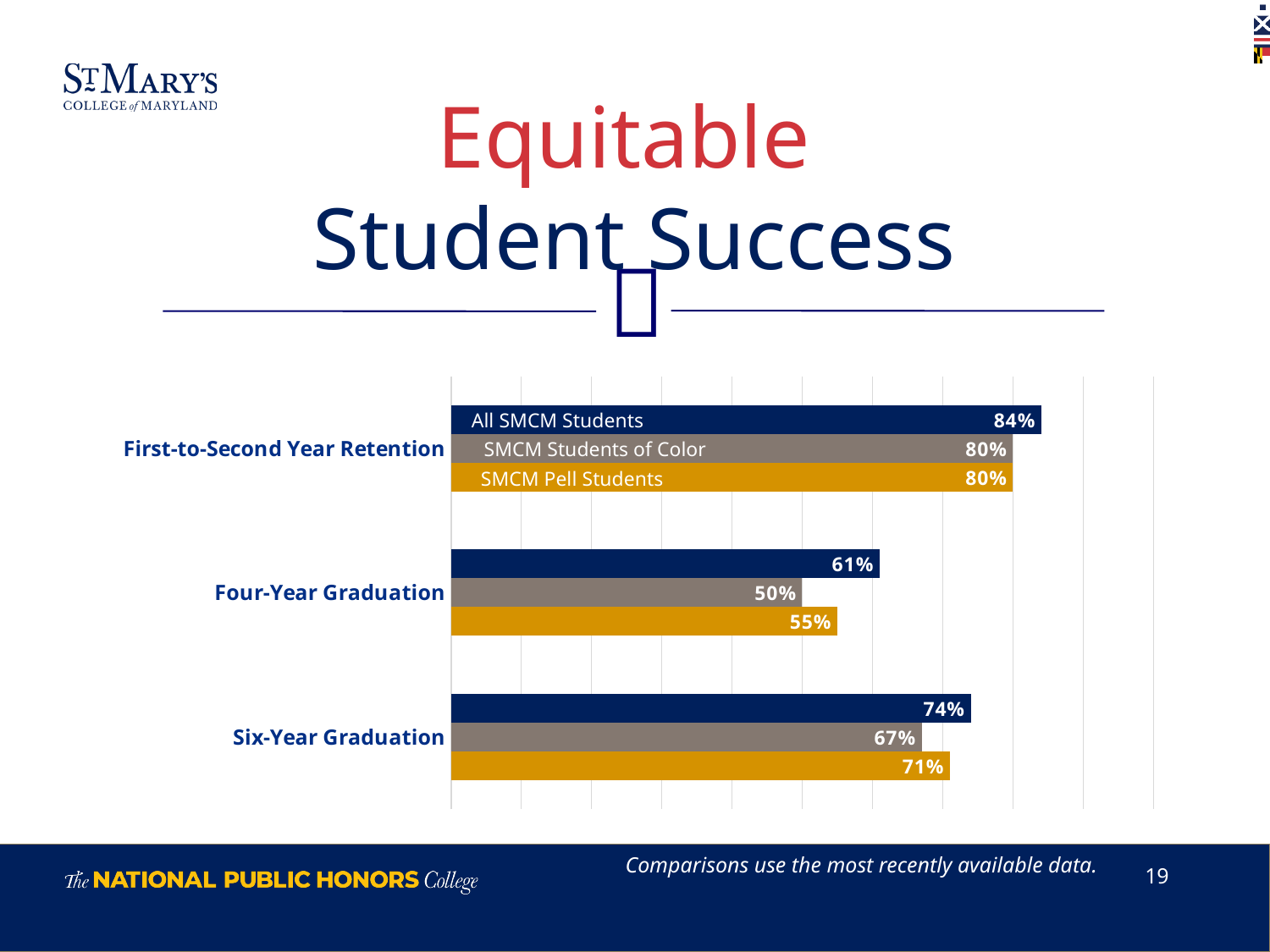
What is the Four-Year Graduation rate for SMCM Students of Color? 50% What is the Six-Year Graduation rate for SMCM Pell Students? 71% How many categories are shown on the chart? 3 What is the First-to-Second Year Retention rate for All SMCM Students? 84% Which series has the lowest Four-Year Graduation rate? SMCM Students of Color How many series does the chart show? 3 What is the Four-Year Graduation rate for SMCM Pell Students? 55% Which is larger: the Four-Year Graduation rate for SMCM Pell Students or for SMCM Students of Color? SMCM Pell Students Which series has the highest Six-Year Graduation rate? All SMCM Students What is the difference between the First-to-Second Year Retention rate for All SMCM Students and for SMCM Pell Students? 4% What type of chart is shown on the slide? Bar chart What is the difference between the Six-Year Graduation rate for All SMCM Students and for SMCM Students of Color? 7%